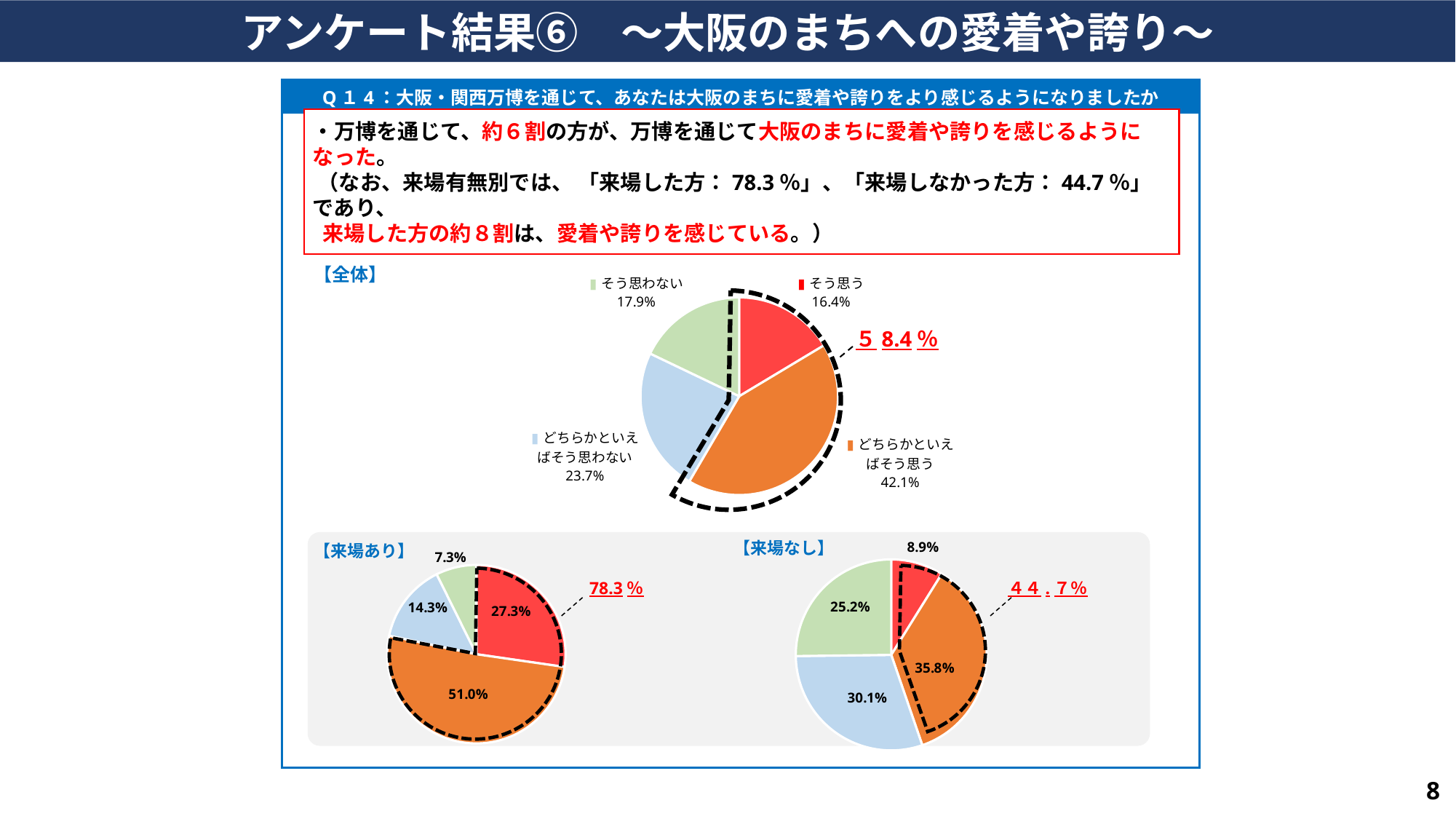
In the 【来場あり】 pie chart, what is the share of the orange slice? 51.0% In the 【全体】 pie chart, what combined percentage is shown for the dashed-outlined slices (そう思う plus どちらかといえばそう思う)? 58.4% In the 【全体】 pie chart, how many slices are there? 4 In the 【全体】 pie chart, what is the difference between どちらかといえばそう思わない and そう思わない? 5.8% In the 【全体】 pie chart, what is the share for そう思う? 16.4% In the 【全体】 pie chart, which category has the largest share? どちらかといえばそう思う What kind of chart is used in the 【全体】 section? pie chart In the 【全体】 pie chart, what is the share for どちらかといえばそう思う? 42.1% In the 【来場なし】 pie chart, what is the share of the red slice? 8.9% In the 【来場あり】 pie chart, what is the share of the smallest slice? 7.3% Which is larger: the orange slice in the 【来場あり】 pie chart or the orange slice in the 【来場なし】 pie chart? 【来場あり】 (51.0%) In the 【全体】 pie chart, which category has the smallest share? そう思う